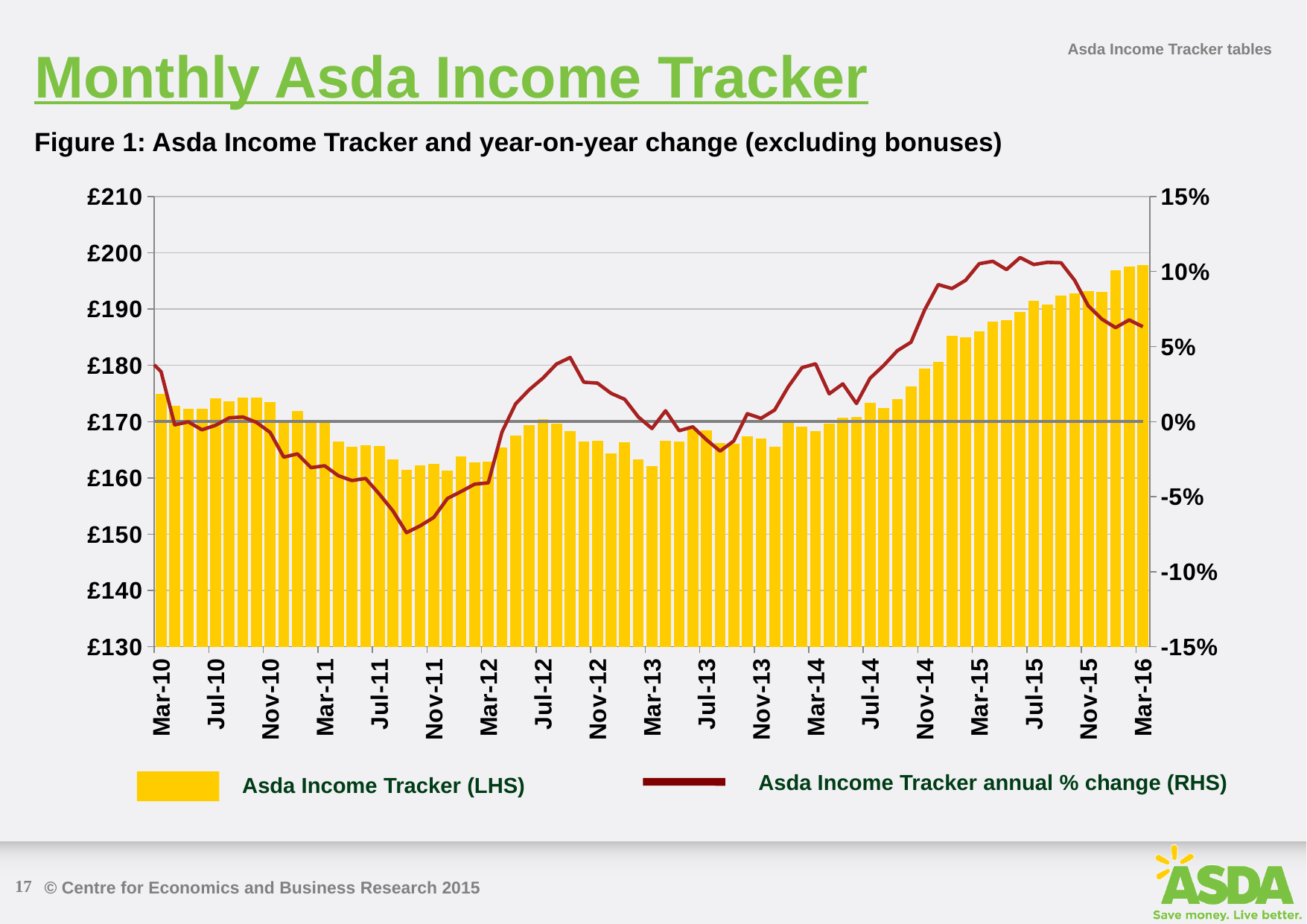
Do the Asda Income Tracker bars rise or fall from Mar-14 to Mar-16? rise Which is larger, the Asda Income Tracker bar for Mar-10 or for Mar-16? Mar-16 Is the Asda Income Tracker value for Mar-16 greater or less than £190? greater Is the annual % change for Mar-16 greater or less than 5%? greater How many series does the legend list? 2 Is the Asda Income Tracker value for Mar-10 greater or less than £170? greater Which month has the highest Asda Income Tracker bar? Mar-16 What is the title of the figure? Figure 1: Asda Income Tracker and year-on-year change (excluding bonuses) What kind of chart is shown on the slide? A combined bar and line chart Which series is plotted as a line on the right-hand axis? Asda Income Tracker annual % change (RHS)